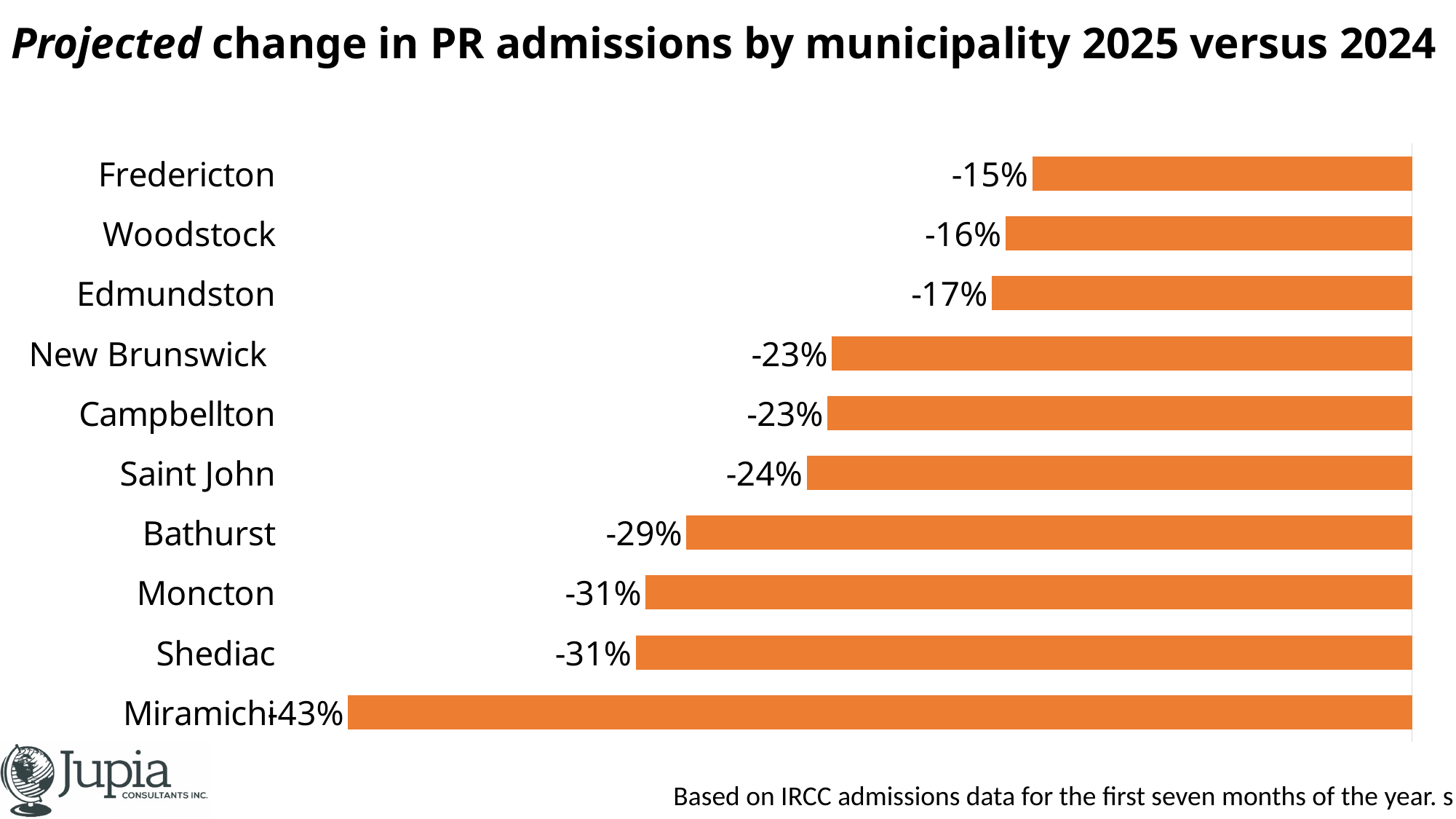
What is the projected change in PR admissions for Saint John? -24% What kind of chart is shown on the slide? Bar chart What is the projected change in PR admissions for Fredericton? -15% What is the difference in percentage points between the projected change for Miramichi and for Fredericton? 28 percentage points How many municipalities or regions are shown in the chart? 10 Which municipality has the smallest projected decline in PR admissions? Fredericton What is the difference in percentage points between the projected change for Bathurst and for Woodstock? 13 percentage points What is the projected change in PR admissions for New Brunswick? -23% What colour are the bars in the chart? Orange Which has a larger projected decline in PR admissions, Moncton or Edmundston? Moncton Which municipality has the largest projected decline in PR admissions? Miramichi What is the projected change in PR admissions for Miramichi? -43%